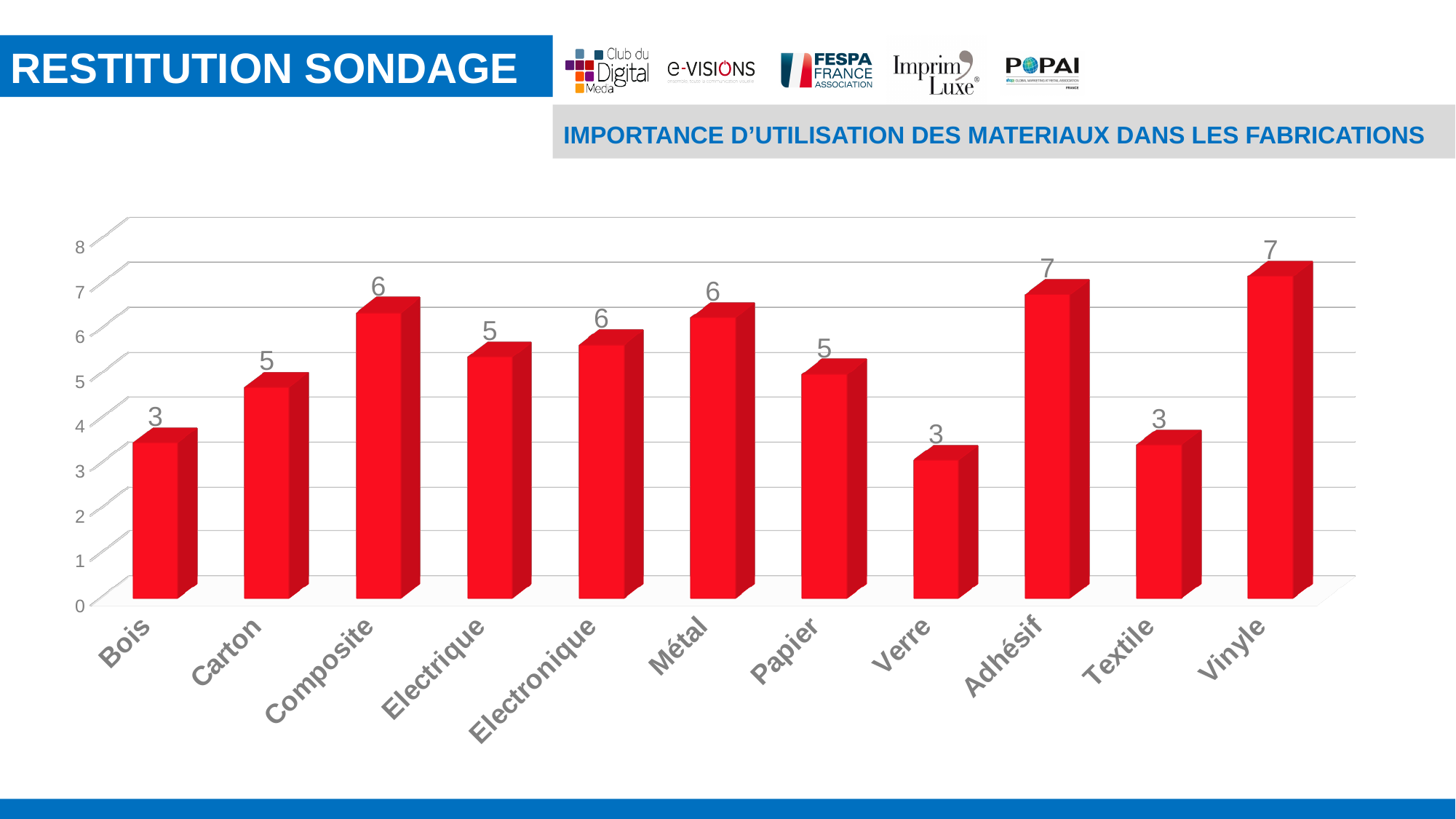
How many categories are shown on the chart? 11 What is the value for Papier? 5 What kind of chart is shown on the slide? bar chart What is the value for Verre? 3 What is the lowest value shown on the chart? 3 What is the value for Composite? 6 What is the difference between the values for Vinyle and Bois? 4 What is the highest value shown on the chart? 7 What is the value for Adhésif? 7 Which has a larger value, Carton or Métal? Métal Is the value for Textile greater or less than 5? less What is the title of the chart? IMPORTANCE D'UTILISATION DES MATERIAUX DANS LES FABRICATIONS